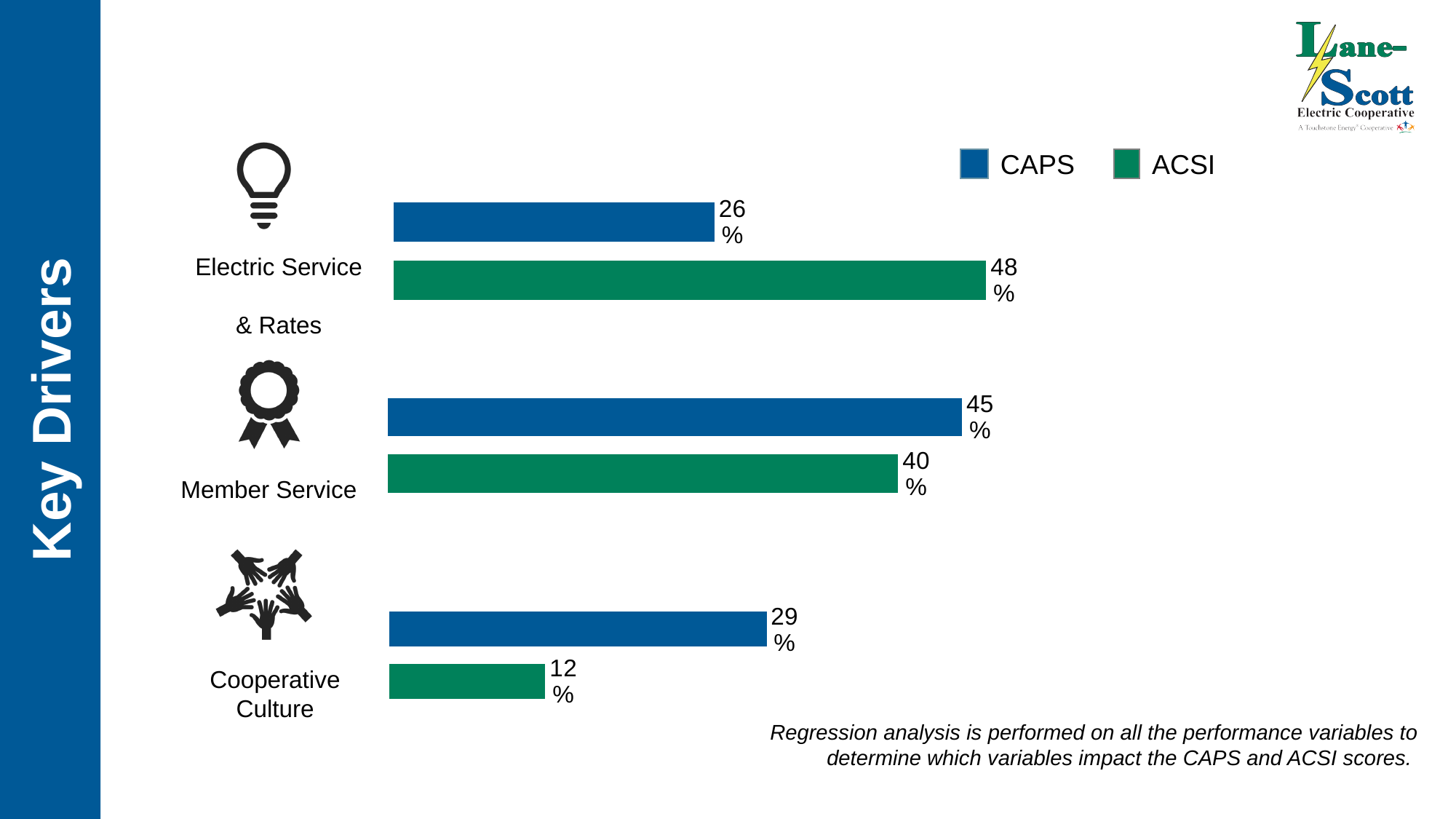
Which category has the lowest ACSI value? Cooperative Culture How many categories are shown in the chart? 3 What is the difference between the ACSI and CAPS values for Electric Service & Rates? 22% What kind of chart is shown on the slide? Bar chart What is the CAPS value for Electric Service & Rates? 26% How many series does the legend list? 2 What is the difference between the CAPS and ACSI values for Cooperative Culture? 17% What is the CAPS value for Member Service? 45% Which category has the highest CAPS value? Member Service For Member Service, which is larger, the CAPS value or the ACSI value? CAPS What is the ACSI value for Cooperative Culture? 12% What is the ACSI value for Electric Service & Rates? 48%